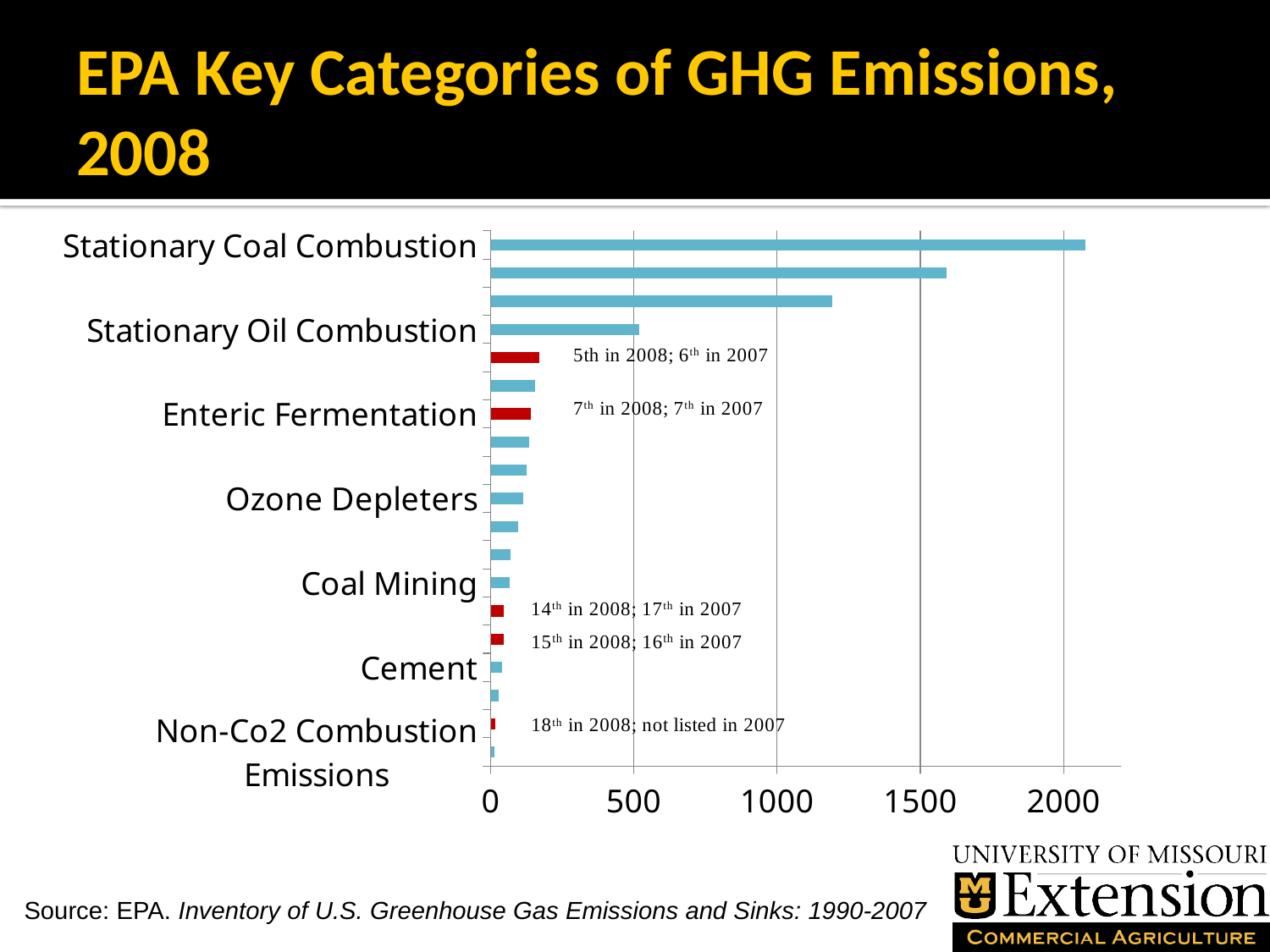
Which labeled category has the highest value? Stationary Coal Combustion What kind of chart is shown on the slide? bar chart What annotation appears next to the Enteric Fermentation bar? 7th in 2008; 7th in 2007 Is the value for Coal Mining greater or less than 500? less Is the value for Enteric Fermentation greater or less than 500? less How many category labels are shown on the vertical axis? 7 Do the bar values rise or fall going from the top of the chart to the bottom? fall Is the value for Stationary Coal Combustion greater or less than 2000? greater What is the highest tick value shown on the horizontal axis? 2000 Which labeled category has the lowest value? Non-Co2 Combustion Emissions Which is larger, the value for Stationary Coal Combustion or the value for Enteric Fermentation? Stationary Coal Combustion Which is larger, the value for Ozone Depleters or the value for Cement? Ozone Depleters